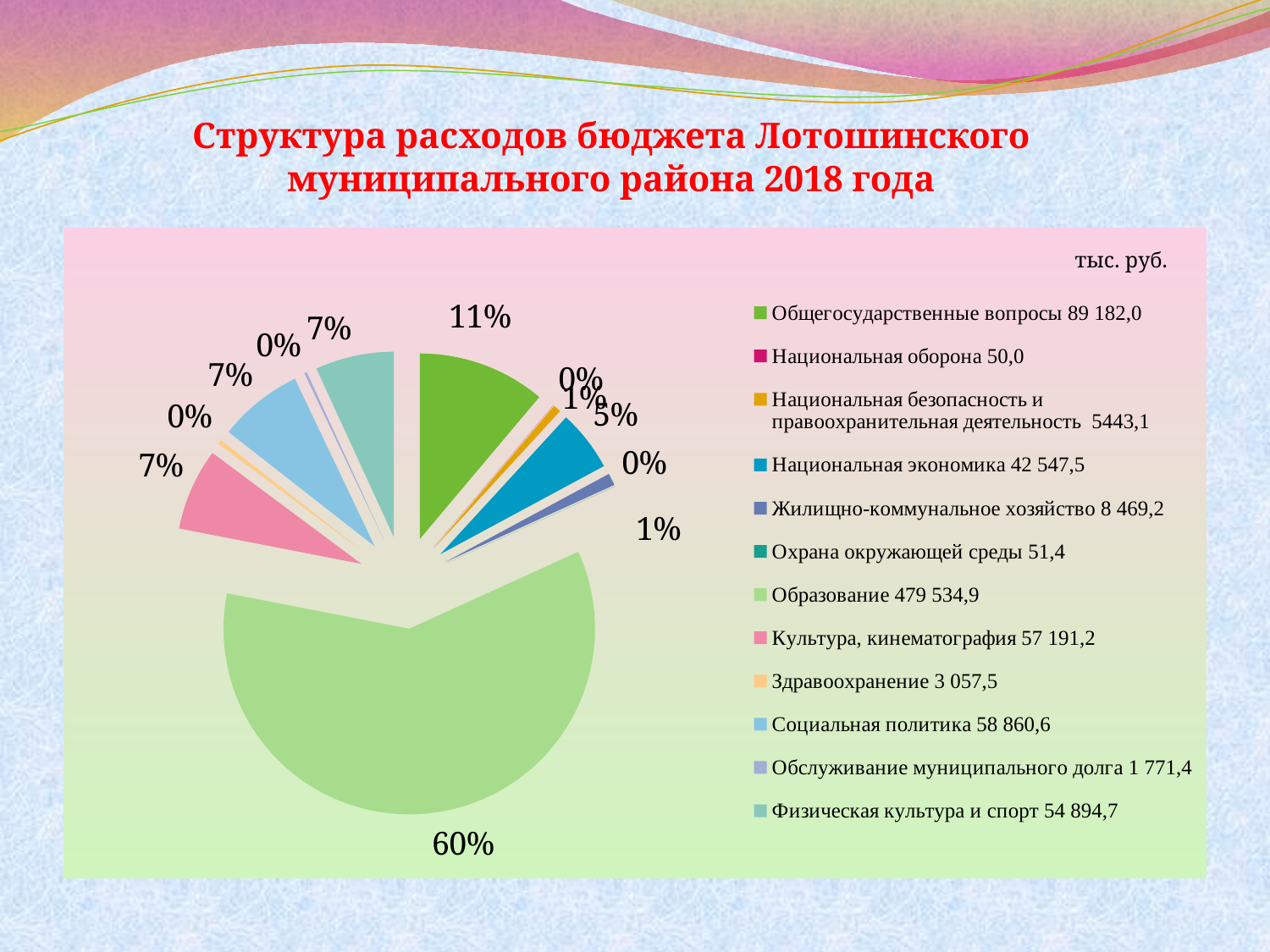
What is the value for Национальная экономика? 42 547,5 Which category has the smallest value in the legend? Национальная оборона What is the value for Обслуживание муниципального долга? 1 771,4 Which is larger: Социальная политика or Культура, кинематография? Социальная политика What share of the pie does Образование take? 60% In what units are the values in the legend given? тыс. руб. What is the difference between Общегосударственные вопросы and Национальная экономика? 46 634,5 How many categories does the legend of the pie chart list? 12 What is the value for Образование in the legend? 479 534,9 What share of the pie does Общегосударственные вопросы take? 11% Which category has the largest share of the pie? Образование What kind of chart is shown on the slide? pie chart